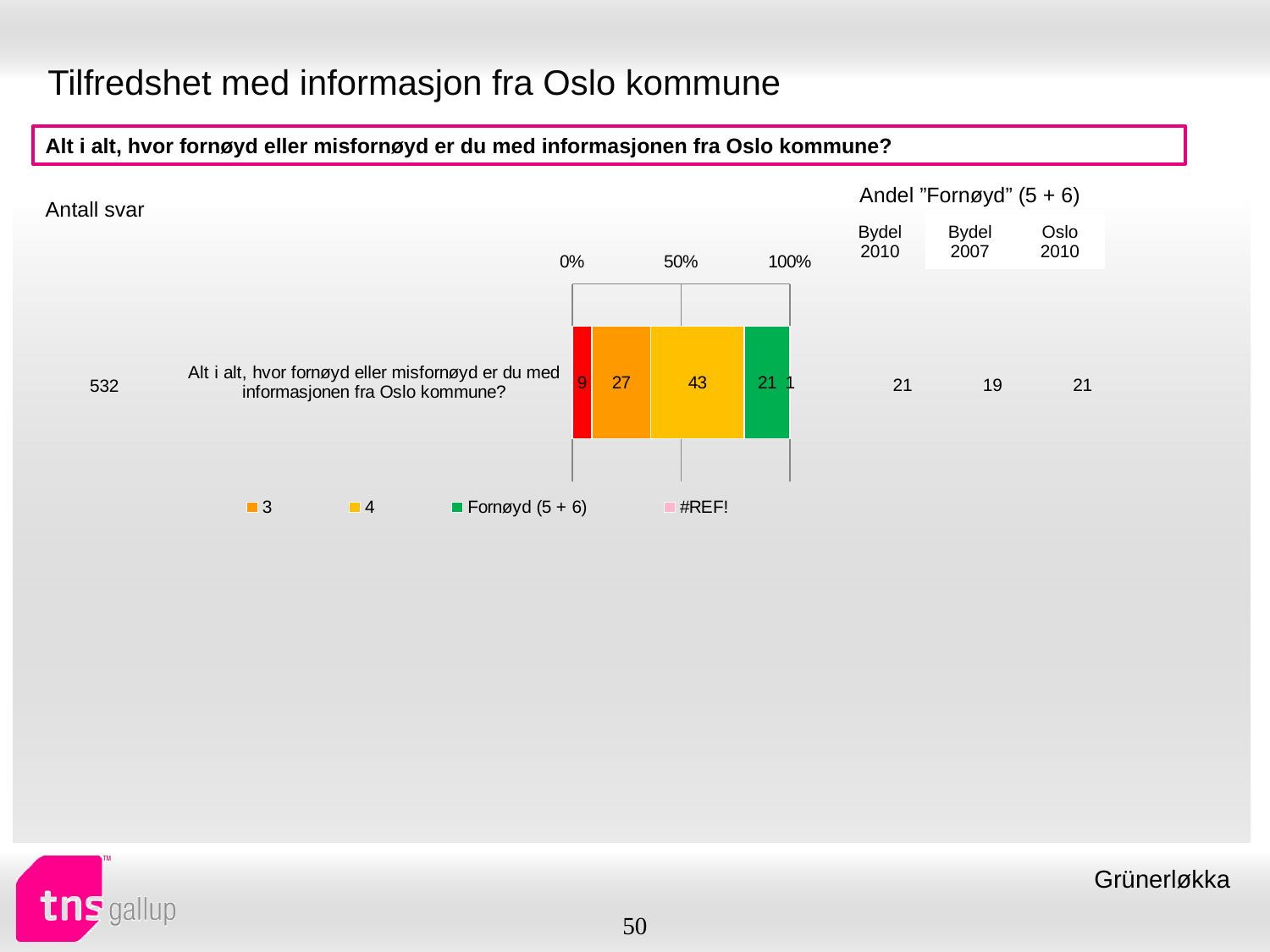
In the "Andel Fornøyd (5 + 6)" table, what is the value for Bydel 2007? 19 What is the value of the segment for category "3" in the stacked bar? 27 What is the value of the "Fornøyd (5 + 6)" segment in the stacked bar? 21 What is the value of the segment for category "4" in the stacked bar? 43 Which legend category has the largest segment in the stacked bar? 4 What is the difference between the "4" segment and the "3" segment? 16 What is the number of responses (Antall svar) shown for the question? 532 What is the value of the red segment at the left of the stacked bar? 9 How many bars does the chart contain? 1 What kind of chart is shown on the slide? Stacked bar chart How many entries does the chart legend list? 4 Which segment is larger, "3" or "Fornøyd (5 + 6)"? 3